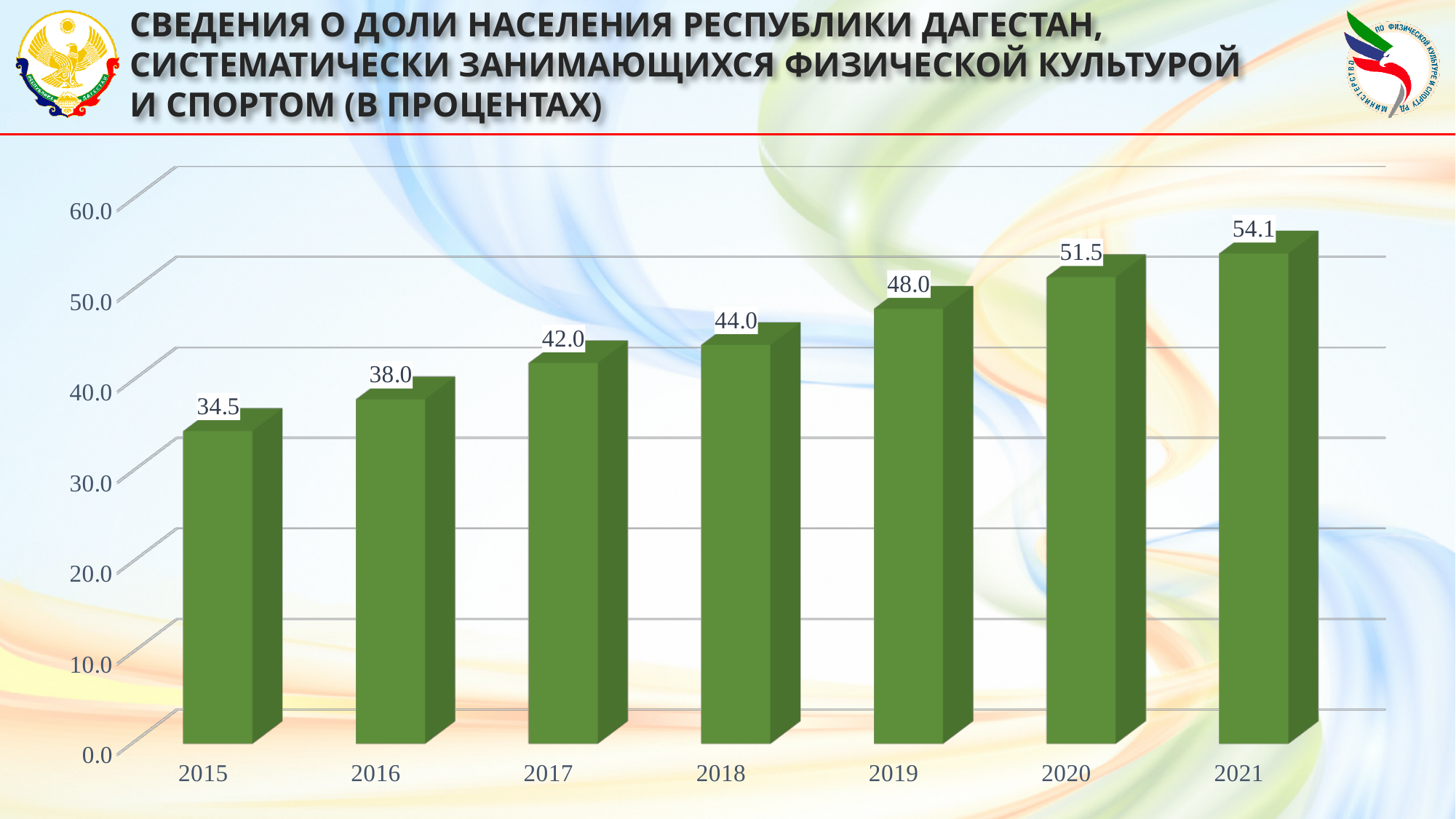
Do the values rise or fall from 2015 to 2021? rise What is the difference between the values for 2021 and 2015? 19.6 What is the difference between the values for 2019 and 2017? 6.0 How many years are shown on the x axis? 7 What is the value for 2021? 54.1 What is the value for 2018? 44.0 What is the value for 2015? 34.5 What kind of chart is shown on the slide? bar chart Which year has the highest value? 2021 Which is larger, the value for 2016 or the value for 2019? 2019 Is the value for 2020 greater or less than 50.0? greater Which year has the lowest value? 2015